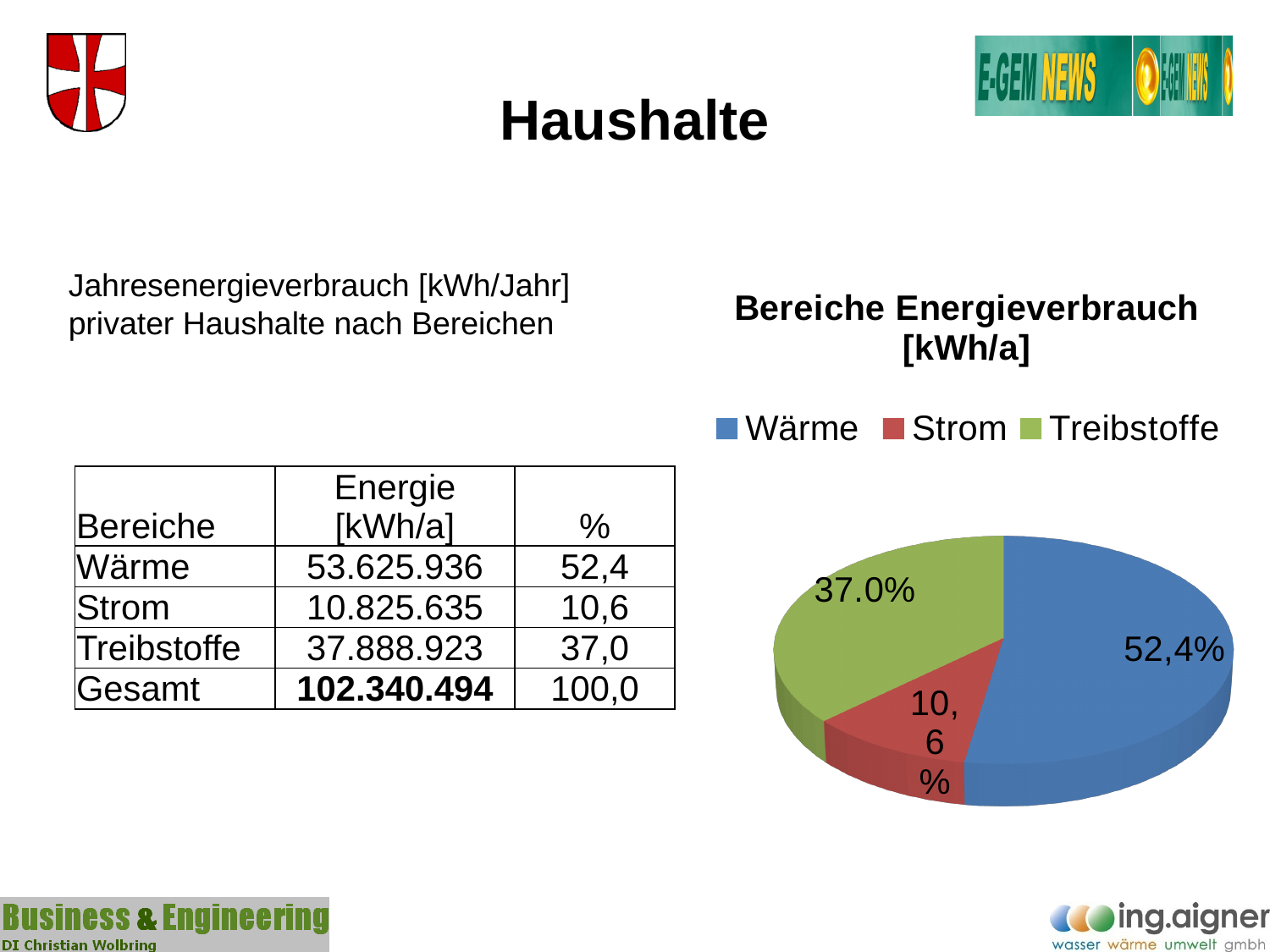
What share of the pie chart does Wärme have? 52,4% What kind of chart is shown on the slide? pie chart Which slice of the pie chart is the smallest? Strom How many slices does the pie chart have? 3 Which slice is larger in the pie chart, Treibstoffe or Strom? Treibstoffe What is the title of the pie chart? Bereiche Energieverbrauch [kWh/a] By how many percentage points does the Wärme share exceed the Strom share in the pie chart? 41,8 What share of the pie chart does Treibstoffe have? 37.0% How many series does the legend of the pie chart list? 3 What share of the pie chart does Strom have? 10,6% Which slice of the pie chart is the largest? Wärme Which colour represents Treibstoffe in the pie chart? green